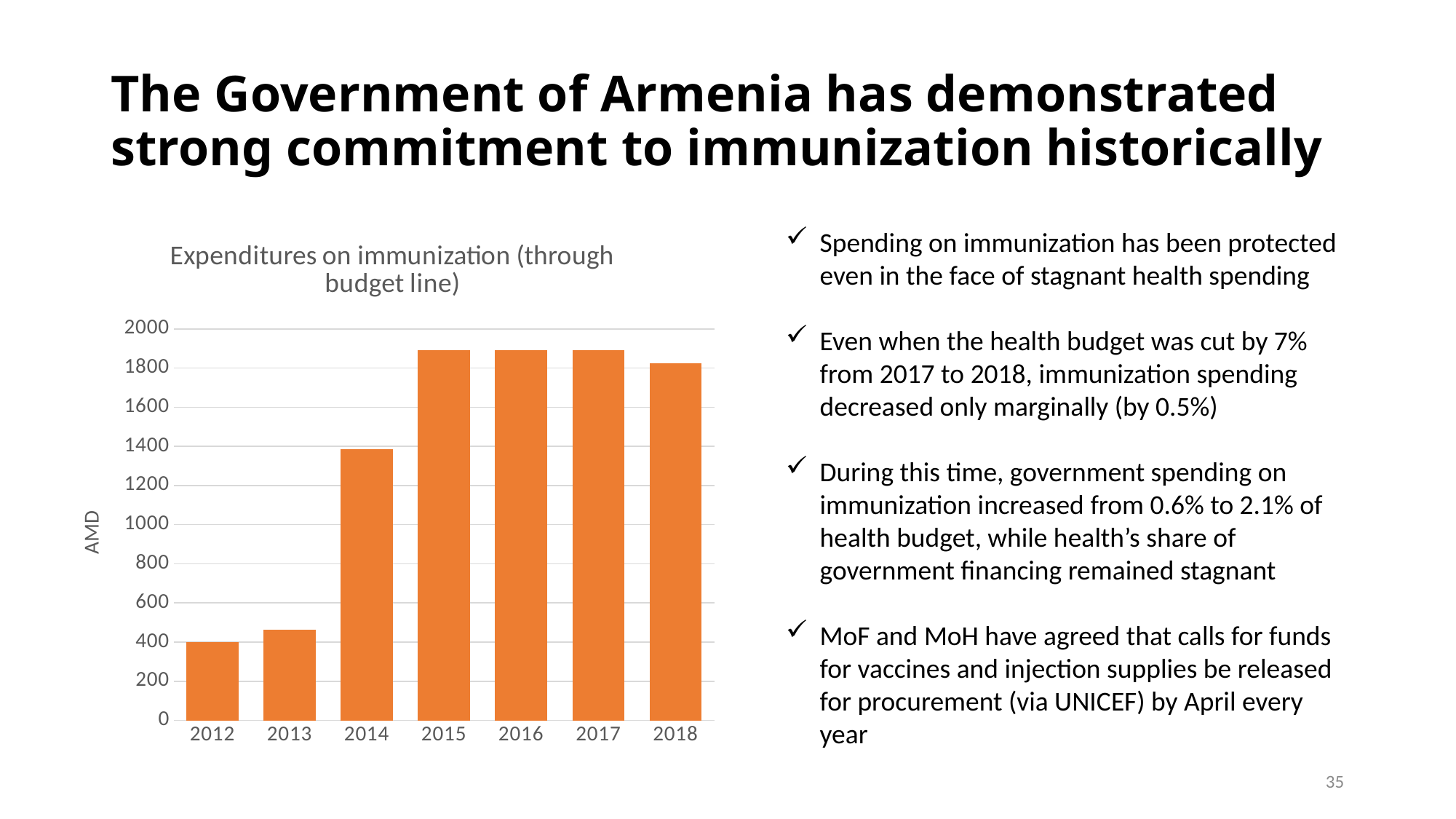
Is the value for 2014 greater or less than 1200? greater Is the value for 2012 greater or less than 600? less Which year has the larger expenditure, 2013 or 2014? 2014 Which year has the larger expenditure, 2014 or 2018? 2018 Is the value for 2015 greater or less than 1800? greater What kind of chart is shown on the slide? bar chart How many years are shown on the x axis of the chart? 7 Do the expenditures generally rise or fall from 2012 to 2017? rise Which year has the lowest expenditure on immunization? 2012 What is the title of the chart? Expenditures on immunization (through budget line)